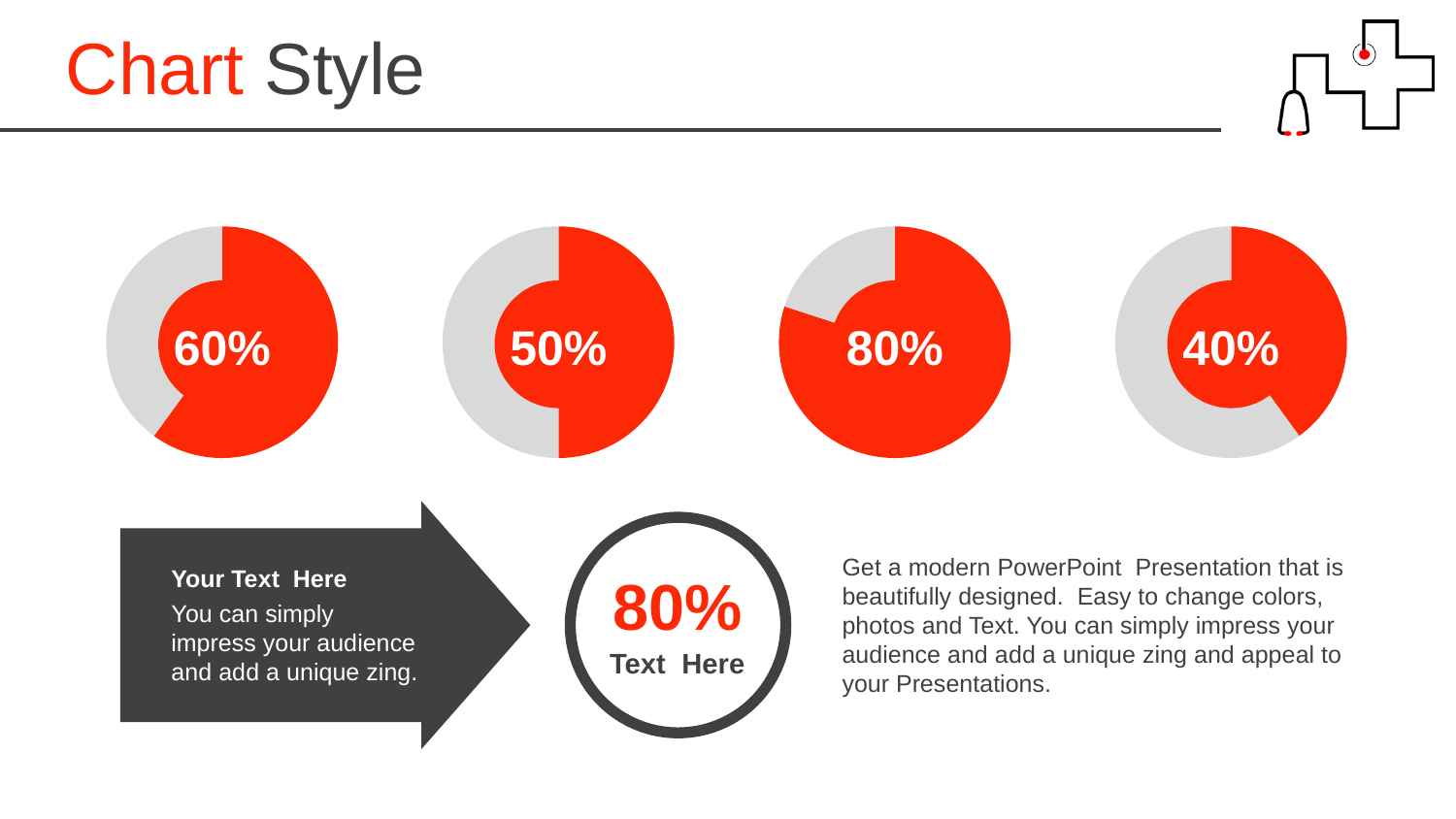
Which is larger, the percentage in the leftmost pie chart or the percentage in the second pie chart? The leftmost (60%) What colour is used for the filled (highlighted) portion of each pie chart? Red What percentage is shown in the third pie chart from the left? 80% Which of the four pie charts shows the lowest percentage? The rightmost (40%) Which of the four pie charts shows the highest percentage? The third from the left (80%) What percentage is shown in the rightmost pie chart? 40% What kind of charts are shown in the top row of the slide? Pie charts What is the difference between the percentage in the third pie chart and the percentage in the rightmost pie chart? 40% What percentage is shown in the second pie chart from the left? 50% How many pie charts are shown in the top row of the slide? 4 What percentage is shown in the leftmost pie chart? 60% What is the title of the slide? Chart Style